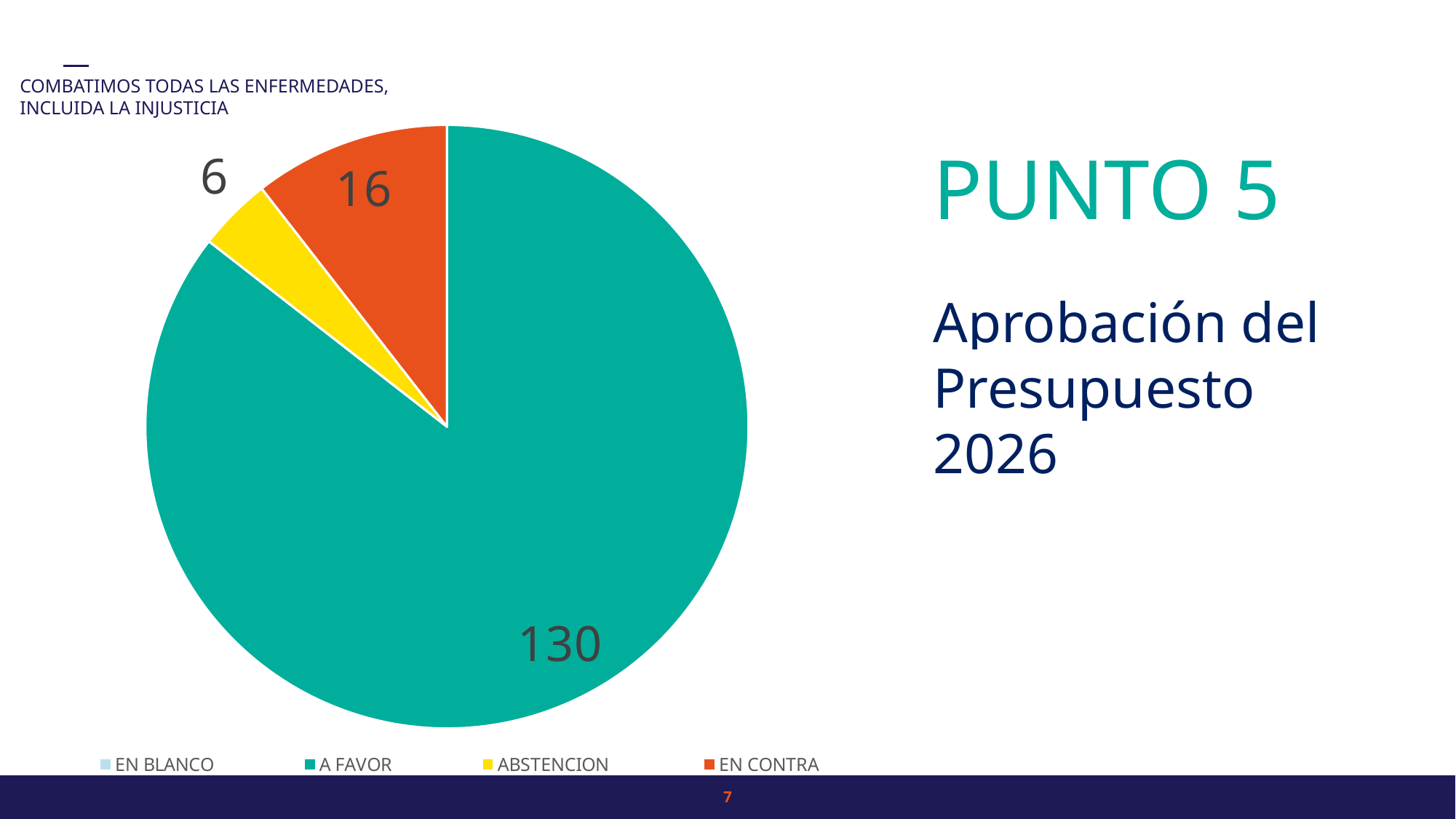
Which legend entry is shown in orange in the pie chart? EN CONTRA Which is larger, EN CONTRA or ABSTENCION? EN CONTRA What is the difference between the A FAVOR value and the EN CONTRA value? 114 What is the difference between the EN CONTRA value and the ABSTENCION value? 10 What kind of chart is shown on the slide? pie chart What is the value for ABSTENCION in the pie chart? 6 What is the value for EN CONTRA in the pie chart? 16 What colour is the A FAVOR slice in the pie chart? teal How many slices with data labels are visible in the pie chart? 3 How many entries does the legend of the pie chart list? 4 What is the value for A FAVOR in the pie chart? 130 Which category has the largest slice in the pie chart? A FAVOR